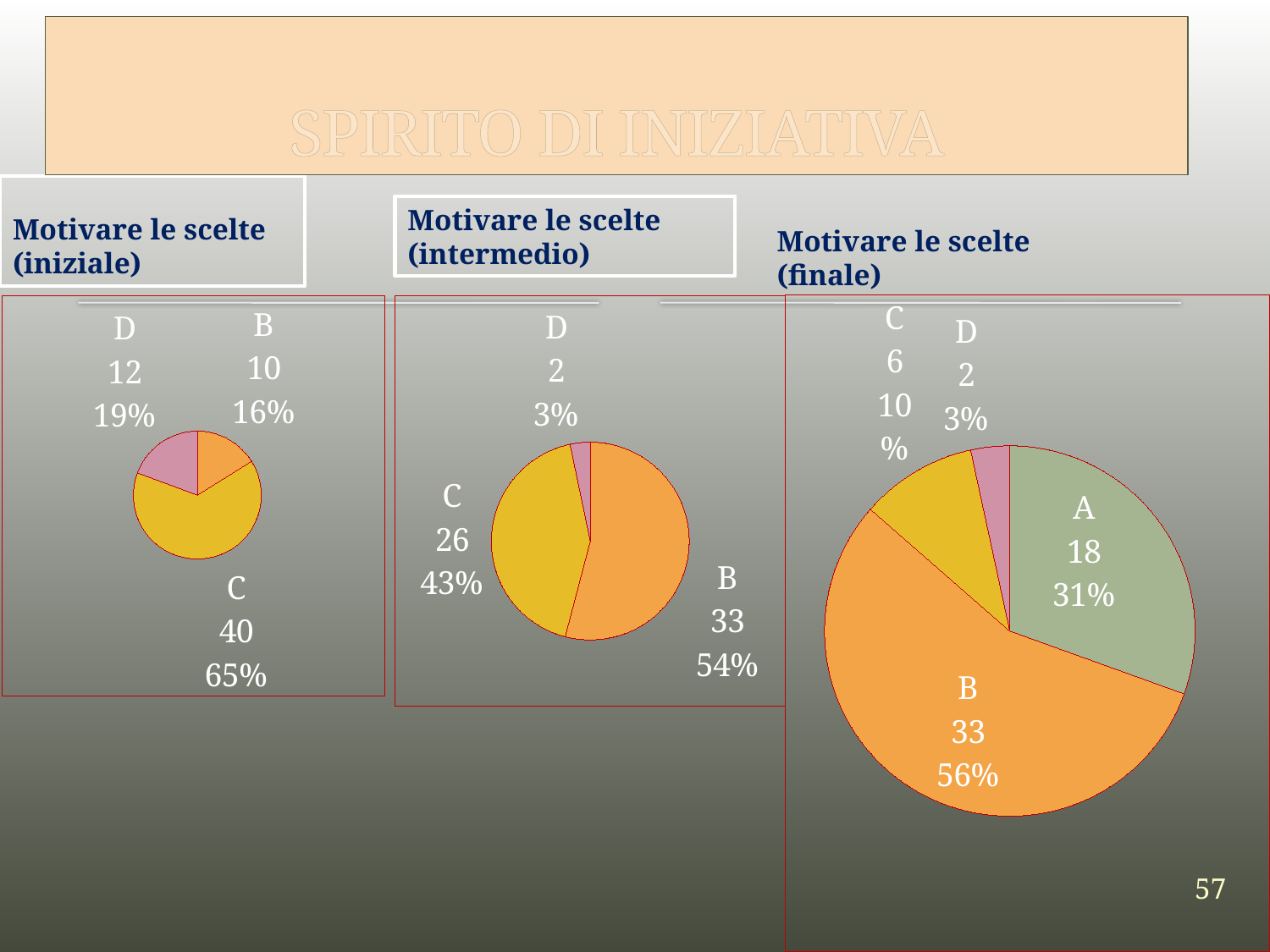
In the 'Motivare le scelte (finale)' chart, how many slices does the pie have? 4 In the 'Motivare le scelte (finale)' chart, what percentage share does B have? 56% In the 'Motivare le scelte (finale)' chart, what is the value for A? 18 In the 'Motivare le scelte (intermedio)' chart, which category has the smallest slice? D In the 'Motivare le scelte (iniziale)' chart, what percentage share does D have? 19% In the 'Motivare le scelte (iniziale)' chart, which category has the largest slice? C In the 'Motivare le scelte (intermedio)' chart, how many slices does the pie have? 3 In the 'Motivare le scelte (intermedio)' chart, what percentage share does C have? 43% What kind of chart is used for 'Motivare le scelte (finale)'? Pie chart In the 'Motivare le scelte (intermedio)' chart, what is the value for B? 33 In the 'Motivare le scelte (iniziale)' chart, what is the value for C? 40 In the 'Motivare le scelte (iniziale)' chart, what is the difference between the values for C and B? 30